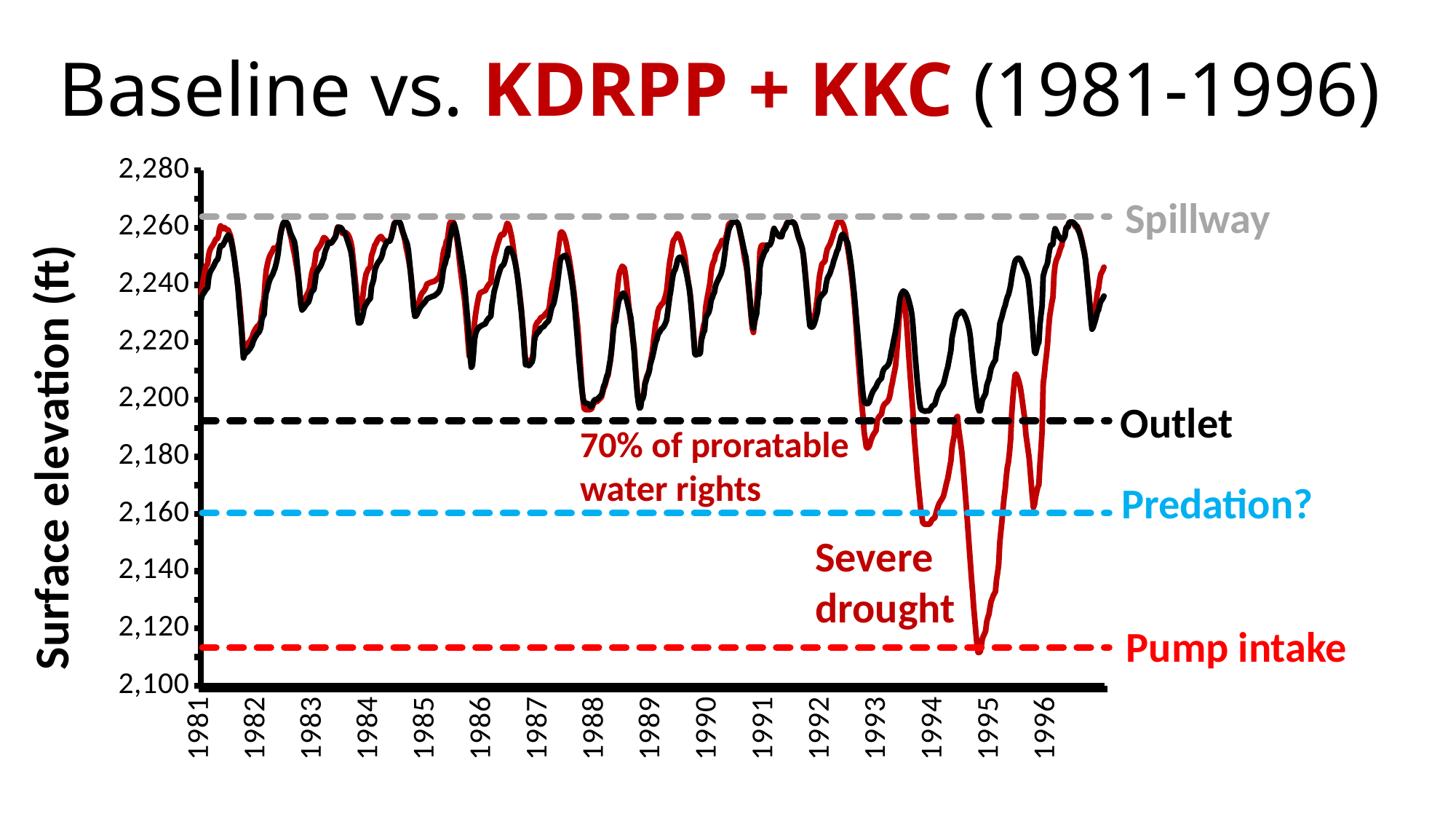
Is the lowest value of the black Baseline line greater or less than 2,180? greater Is the Predation? reference line above or below the Outlet reference line? below Which series drops lower during the 1994-1995 drought, the black Baseline or the red KDRPP + KKC? Red KDRPP + KKC In which year does the red KDRPP + KKC line reach its lowest point? 1994 What is the title of the chart on the slide? Baseline vs. KDRPP + KKC (1981-1996) Which of the dashed reference lines is at the lowest elevation? Pump intake Is the lowest value of the red KDRPP + KKC line greater or less than 2,140? less Which of the dashed reference lines is at the highest elevation? Spillway How many data series (solid lines) are plotted on the chart? 2 What kind of chart is shown on the slide? Line chart What is the label of the vertical axis? Surface elevation (ft) How many years are labelled along the horizontal axis? 16